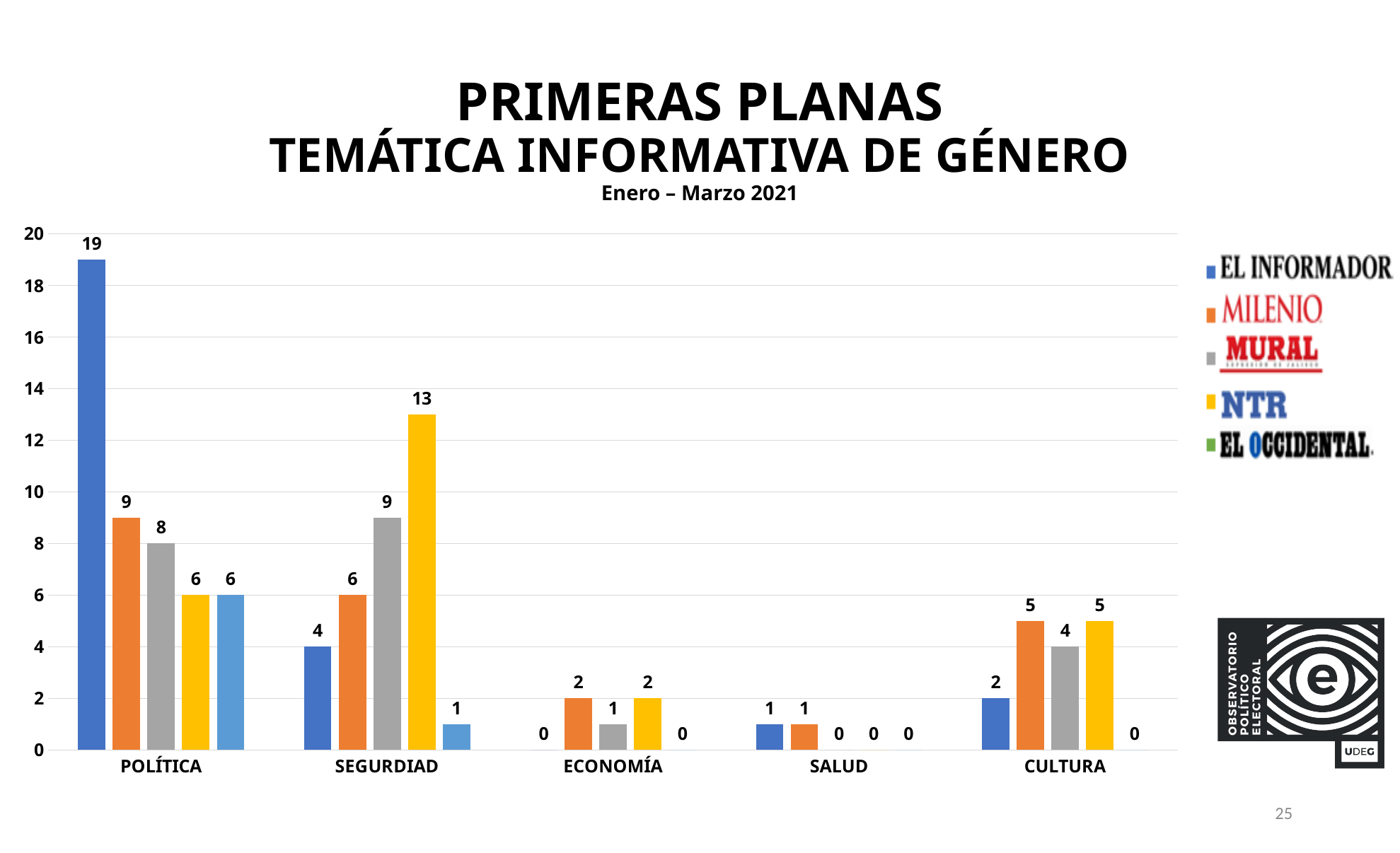
What is the value for Mural in the CULTURA category? 4 Which is larger: Mural's value in SEGURDIAD or Mural's value in POLÍTICA? Mural's value in SEGURDIAD What type of chart is shown on the slide? bar chart What is the value for El Informador in the POLÍTICA category? 19 What is the value for NTR in the SEGURDIAD category? 13 What is the value for Milenio in the ECONOMÍA category? 2 How many categories are shown on the x axis? 5 What is the difference between El Informador's value and Milenio's value in the POLÍTICA category? 10 What period is stated in the chart subtitle? Enero – Marzo 2021 Which newspaper has the highest value in the POLÍTICA category? El Informador Which newspaper has the highest value in the SEGURDIAD category? NTR How many series does the legend list? 5